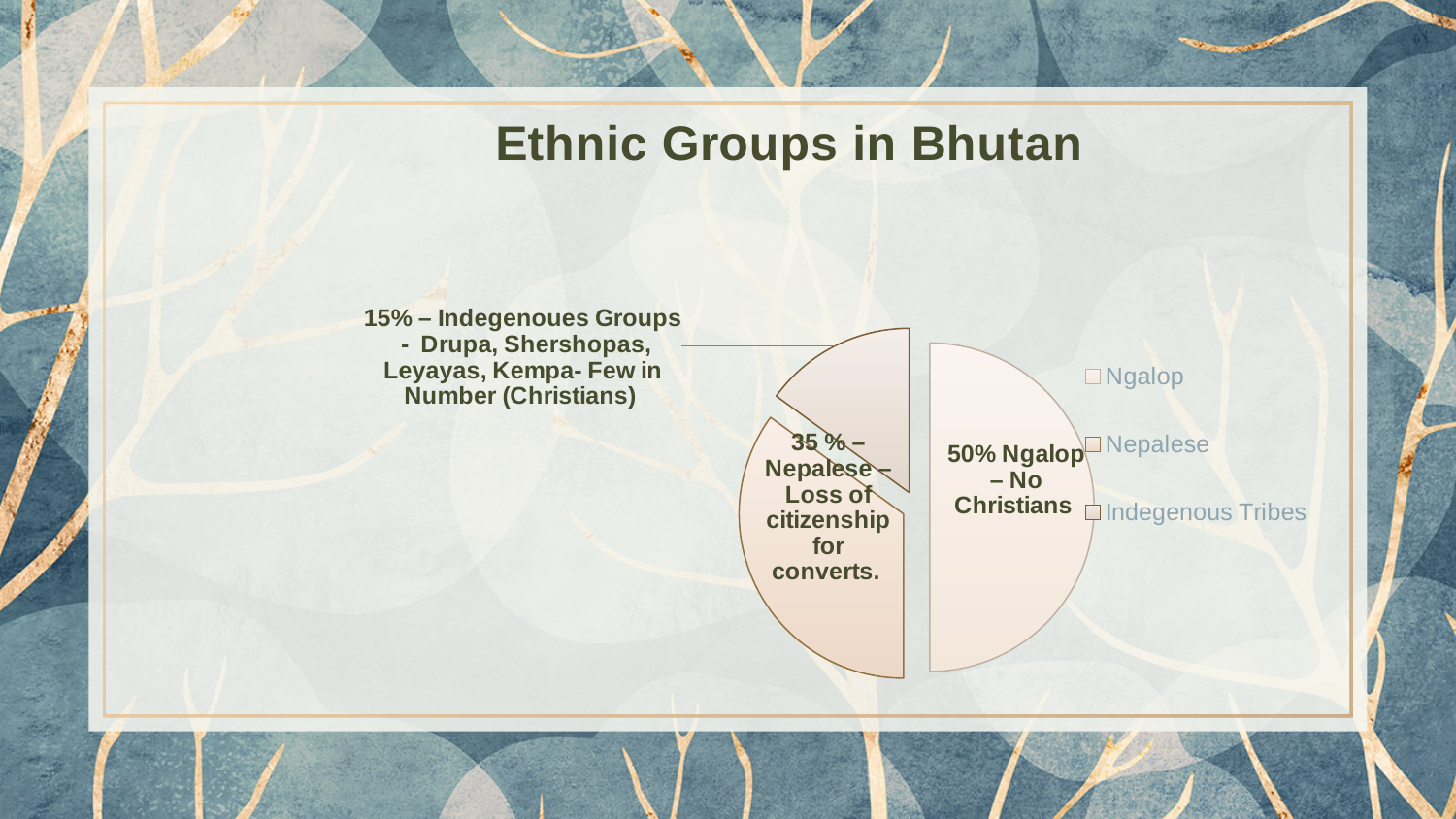
What share of the pie does Nepalese represent? 35 % Which legend entry is listed first? Ngalop What kind of chart is shown on the slide? pie chart What is the title of the chart? Ethnic Groups in Bhutan Which slice is larger, Nepalese or Indegenous Tribes? Nepalese Which ethnic group has the smallest slice of the pie? Indegenous Tribes How many slices does the pie chart have? 3 What share of the pie do the Indegenous Tribes represent? 15% What share of the pie does Ngalop represent? 50% What is the difference in percentage points between the Ngalop and Nepalese slices? 15 Which ethnic group has the largest slice of the pie? Ngalop How many entries does the legend list? 3